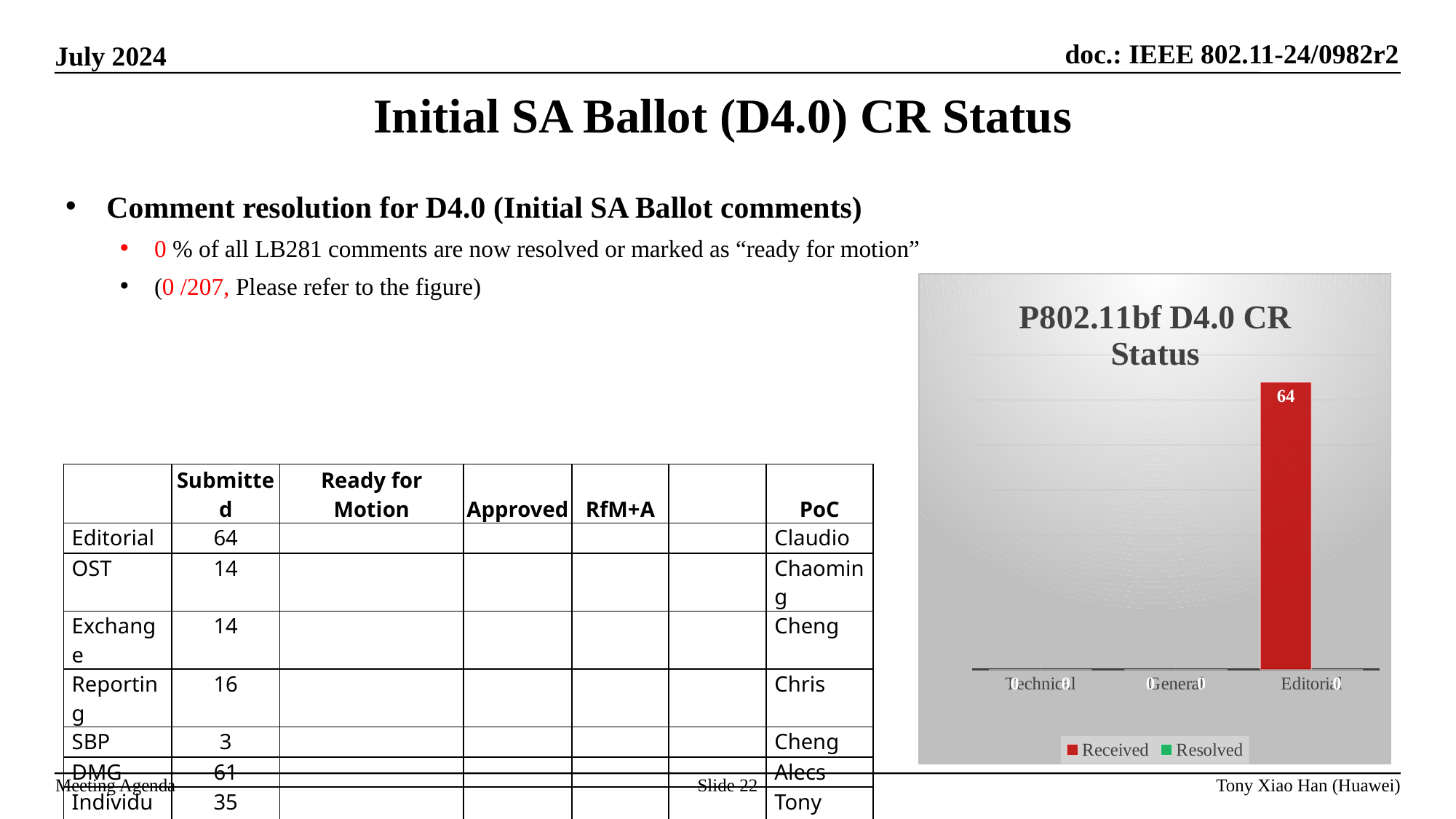
What is the Received value for Technical in the chart? 0 What is the title of the chart on the slide? P802.11bf D4.0 CR Status What is the Resolved value for Editorial in the chart? 0 How many categories are shown on the x axis of the chart? 3 What are the two series named in the chart's legend? Received and Resolved What kind of chart is shown on the slide? bar chart How many series does the chart's legend list? 2 Which category has the highest Received value in the chart? Editorial What is the Received value for Editorial in the chart? 64 Which is larger in the chart, the Received value for Editorial or for General? Editorial